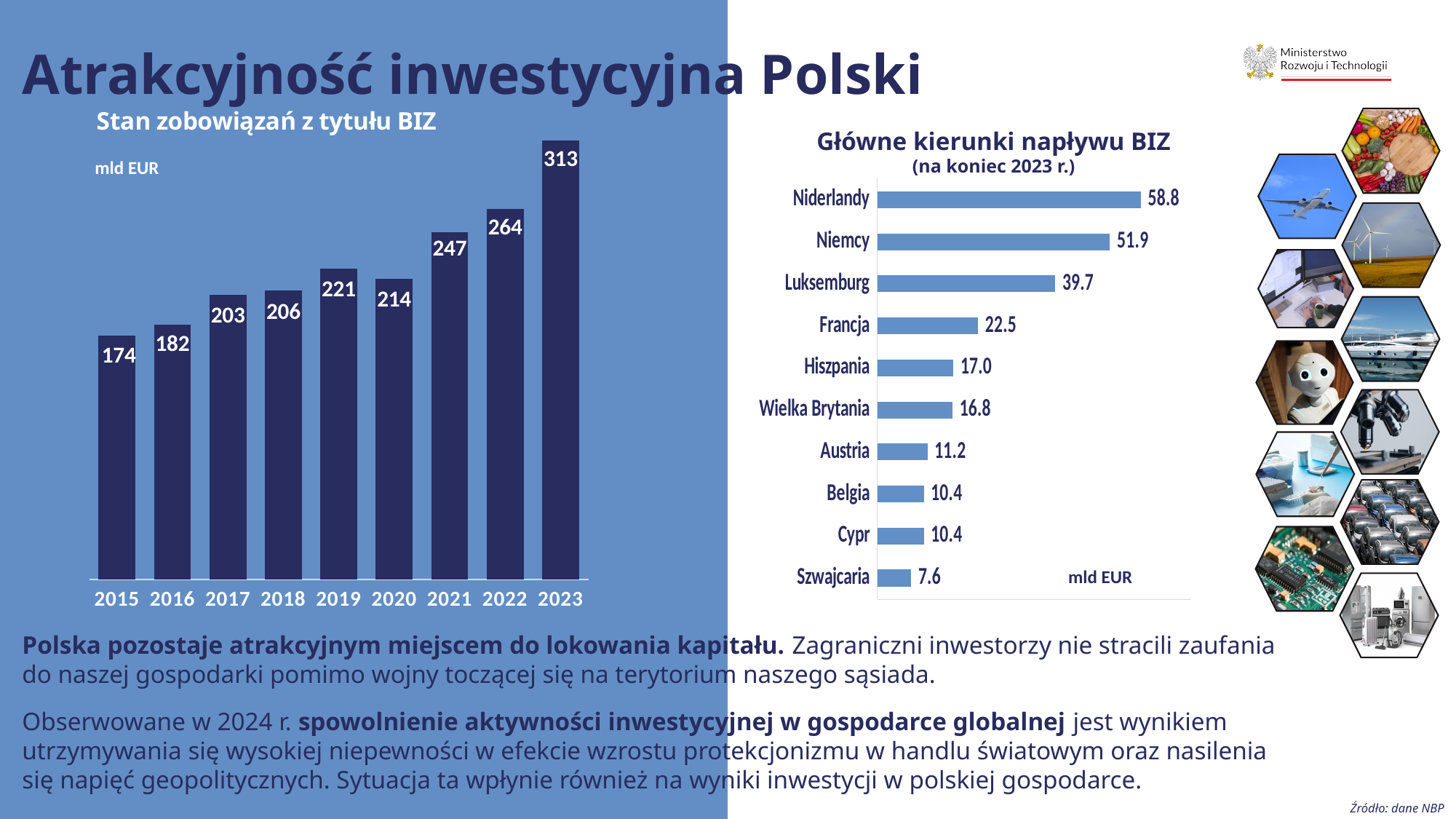
In the chart 'Stan zobowiązań z tytułu BIZ', which year has the lowest value? 2015 In the chart 'Stan zobowiązań z tytułu BIZ', what is the difference between the values for 2023 and 2022? 49 How many countries are shown in the chart 'Główne kierunki napływu BIZ'? 10 In the chart 'Główne kierunki napływu BIZ', what is the value for Luksemburg? 39.7 In the chart 'Stan zobowiązań z tytułu BIZ', what is the value for 2015? 174 In the chart 'Stan zobowiązań z tytułu BIZ', what is the value for 2023? 313 In the chart 'Główne kierunki napływu BIZ', which country has the lowest value? Szwajcaria In the chart 'Główne kierunki napływu BIZ', which country has the highest value? Niderlandy In the chart 'Stan zobowiązań z tytułu BIZ', which is larger, the value for 2019 or the value for 2020? 2019 In the chart 'Główne kierunki napływu BIZ', what is the difference between the values for Niderlandy and Niemcy? 6.9 How many years are shown in the chart 'Stan zobowiązań z tytułu BIZ'? 9 What kind of chart is 'Stan zobowiązań z tytułu BIZ'? bar chart